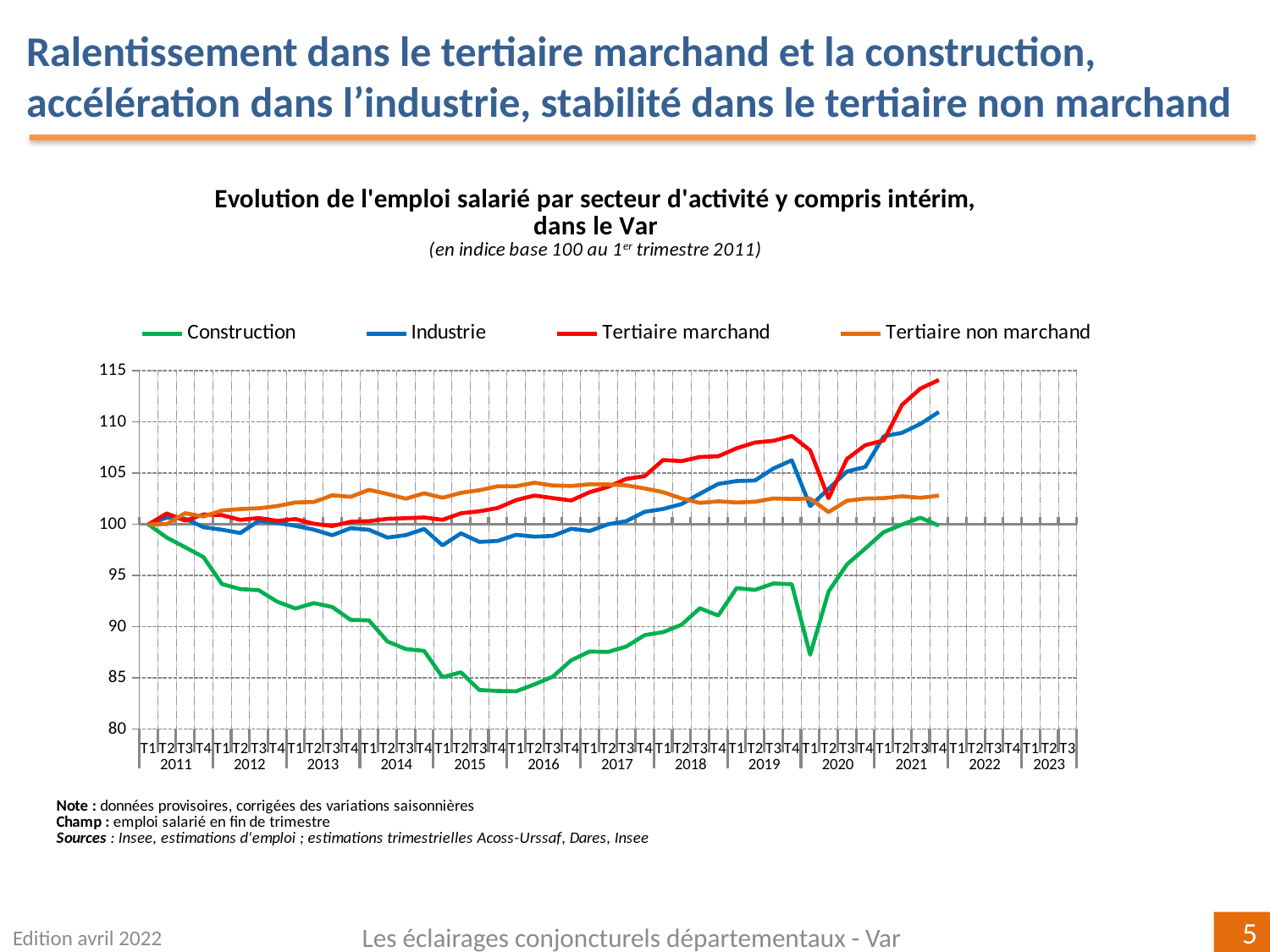
How many series does the legend list? 4 Is the value for Construction in T1 2016 greater or less than 85? less Which series has the lowest value at the last plotted point (T4 2021)? Construction Is the value for Tertiaire non marchand at T4 2021 greater or less than 105? less Which series has the highest value at the last plotted point (T4 2021)? Tertiaire marchand What kind of chart is shown on the slide? line chart At T1 2020, which is lower: Construction or Industrie? Construction What colour is the Construction line? green Is the value for Tertiaire marchand at T4 2021 greater or less than 110? greater At T4 2021, which is larger: Industrie or Tertiaire non marchand? Industrie Does the Construction series rise or fall between 2011 and 2016? fall Does the Tertiaire marchand series rise or fall overall between 2011 and 2021? rise